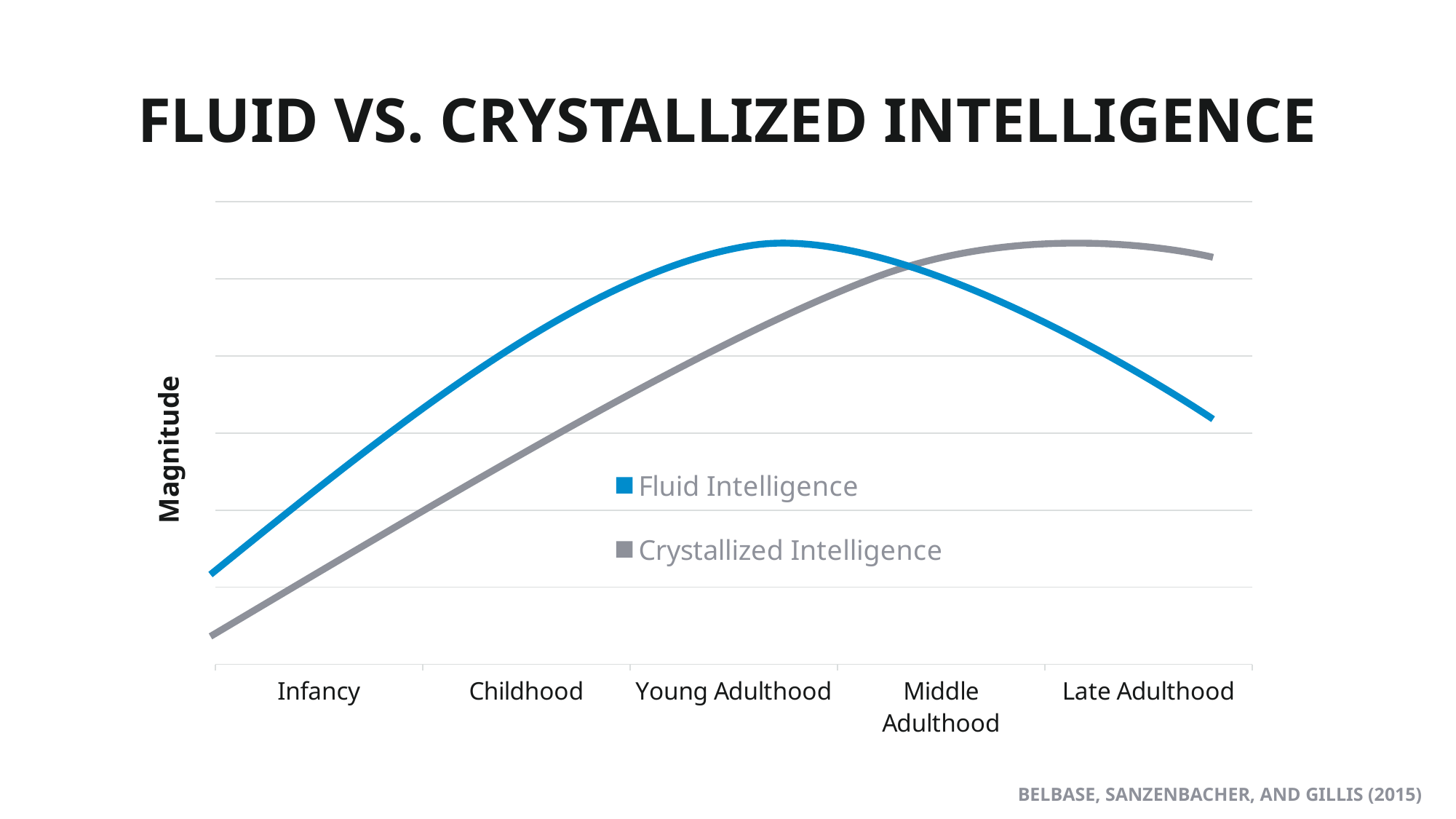
How many series does the legend list? 2 At Infancy, which series is higher, Fluid Intelligence or Crystallized Intelligence? Fluid Intelligence What kind of chart is shown on the slide? Line chart At which life stage does Crystallized Intelligence reach its highest point? Late Adulthood How many life-stage categories are labelled on the x axis? 5 At which life stage is Crystallized Intelligence at its lowest? Infancy What is the label on the vertical axis? Magnitude At Late Adulthood, which series is higher, Fluid Intelligence or Crystallized Intelligence? Crystallized Intelligence At which life stage does Fluid Intelligence reach its highest point? Young Adulthood What is the title of the chart? FLUID VS. CRYSTALLIZED INTELLIGENCE Does Crystallized Intelligence rise or fall from Infancy to Young Adulthood? Rise Does Fluid Intelligence rise or fall from Middle Adulthood to Late Adulthood? Fall